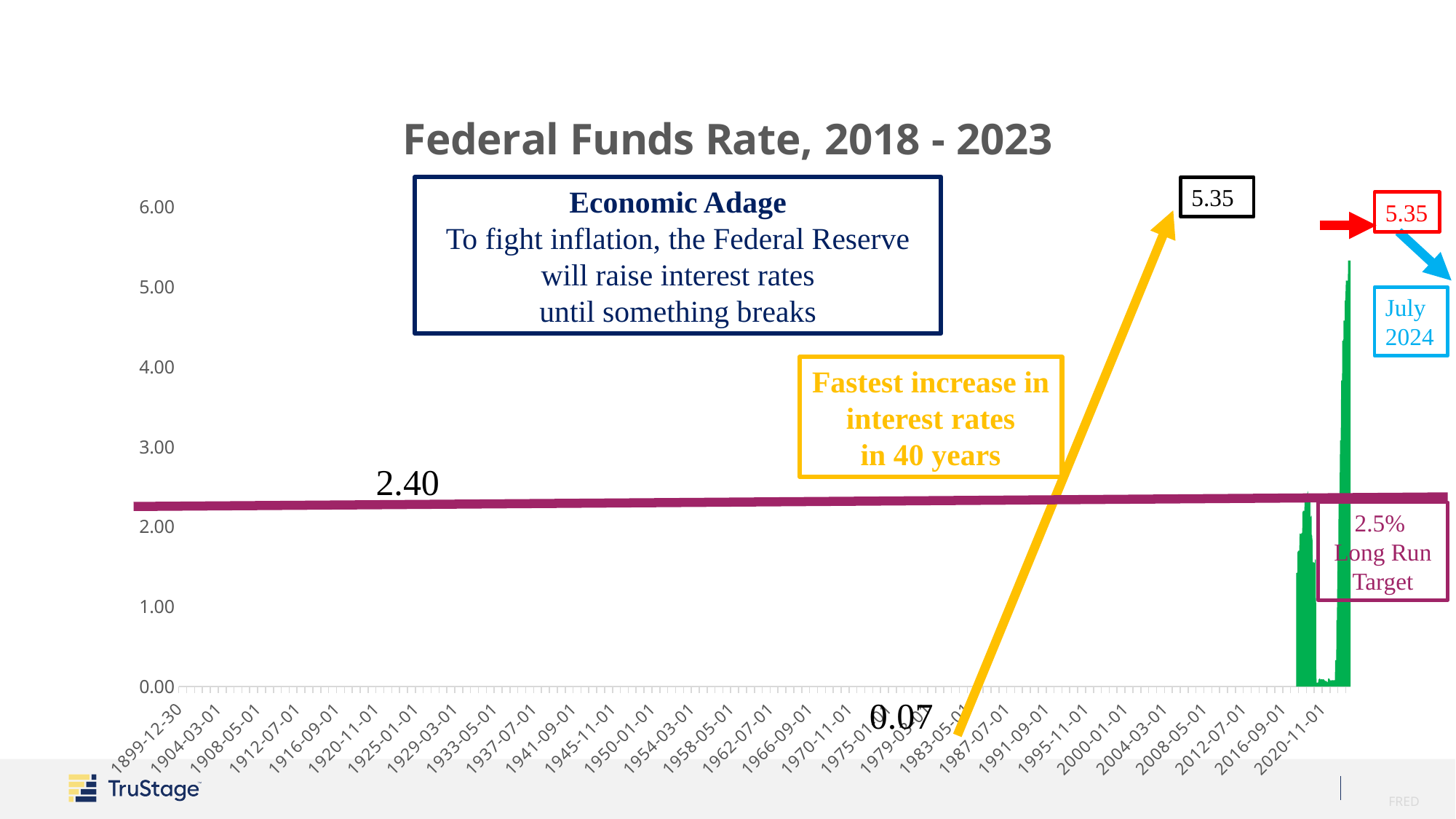
What is the title of the chart? Federal Funds Rate, 2018 - 2023 What is the difference between the labeled peak value (5.35) and the labeled low value (0.07)? 5.28 What is the highest value shown on the y-axis? 6.00 Is the peak value of the green line greater or less than 5.00? greater Is the value of the purple horizontal line greater or less than 3.00? less Which is larger: the labeled peak of the green line (5.35) or the labeled value of the purple line (2.40)? 5.35 What is the peak value of the Federal Funds Rate labeled on the chart? 5.35 What is the lowest value of the Federal Funds Rate labeled on the chart? 0.07 What value is labeled at the start of the purple horizontal line? 2.40 What kind of chart is shown on the slide? line chart What long run target is stated in the purple box on the chart? 2.5% What does the yellow box on the chart say? Fastest increase in interest rates in 40 years